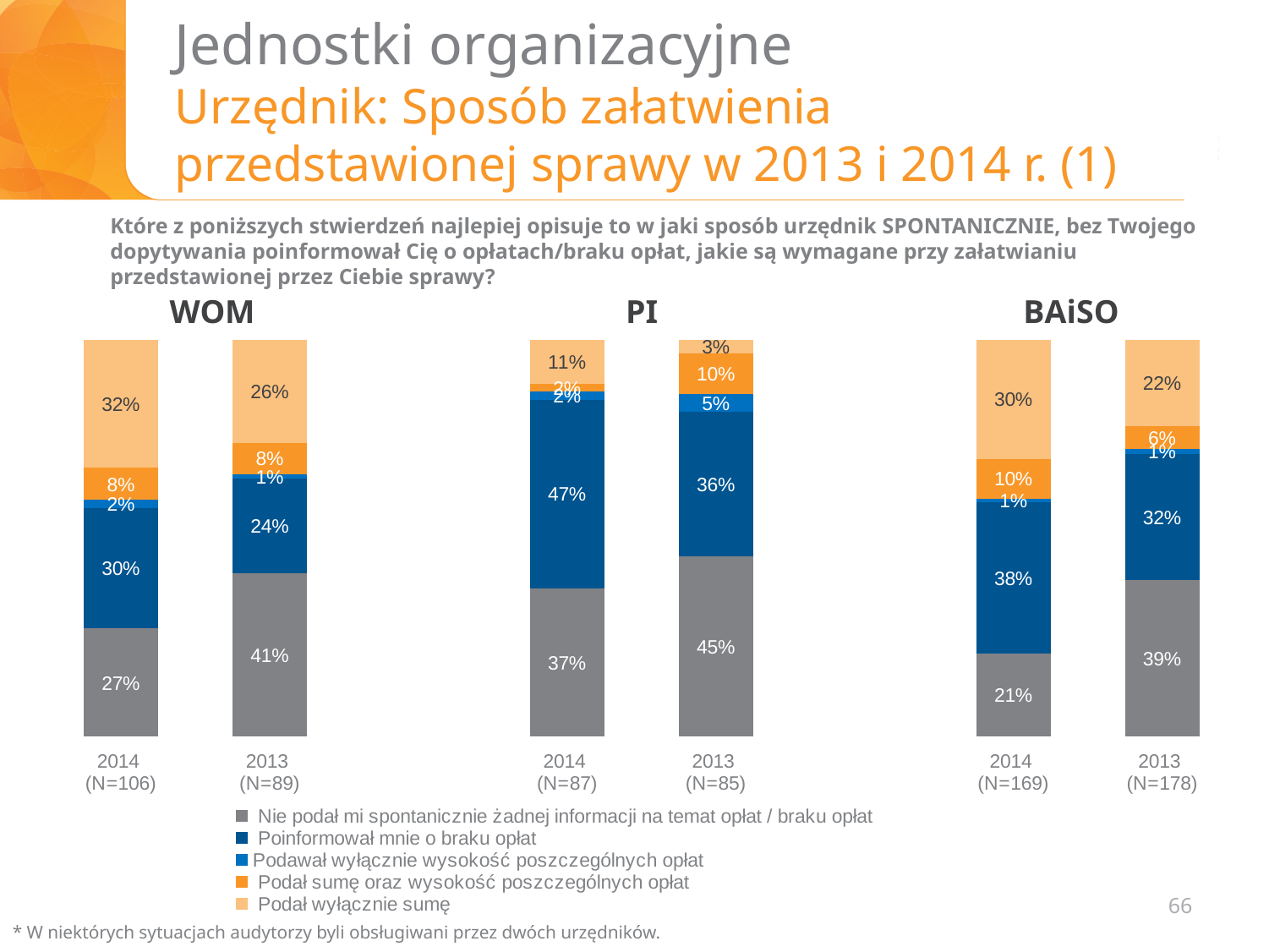
In the BAiSO chart, what is the value for 'Nie podał mi spontanicznie żadnej informacji na temat opłat / braku opłat' in 2014? 21% How many series does the legend list? 5 In the WOM chart, what is the difference between the 2013 and 2014 values for 'Nie podał mi spontanicznie żadnej informacji na temat opłat / braku opłat'? 14 percentage points In the BAiSO chart, which year has the larger value for 'Poinformował mnie o braku opłat', 2014 or 2013? 2014 In the PI chart, which year has the larger value for 'Podał wyłącznie sumę', 2014 or 2013? 2014 In the PI chart, what is the value for 'Poinformował mnie o braku opłat' in 2014? 47% In the PI chart, what is the value for 'Podał sumę oraz wysokość poszczególnych opłat' in 2013? 10% In the WOM chart, what is the value for 'Nie podał mi spontanicznie żadnej informacji na temat opłat / braku opłat' in 2014? 27% What kind of chart is used for WOM, PI and BAiSO? Stacked bar chart In the WOM chart, what is the value for 'Podał wyłącznie sumę' in 2013? 26% In the BAiSO chart, what is the value for 'Poinformował mnie o braku opłat' in 2013? 32% In the PI chart, what is the sample size (N) for 2013? N=85